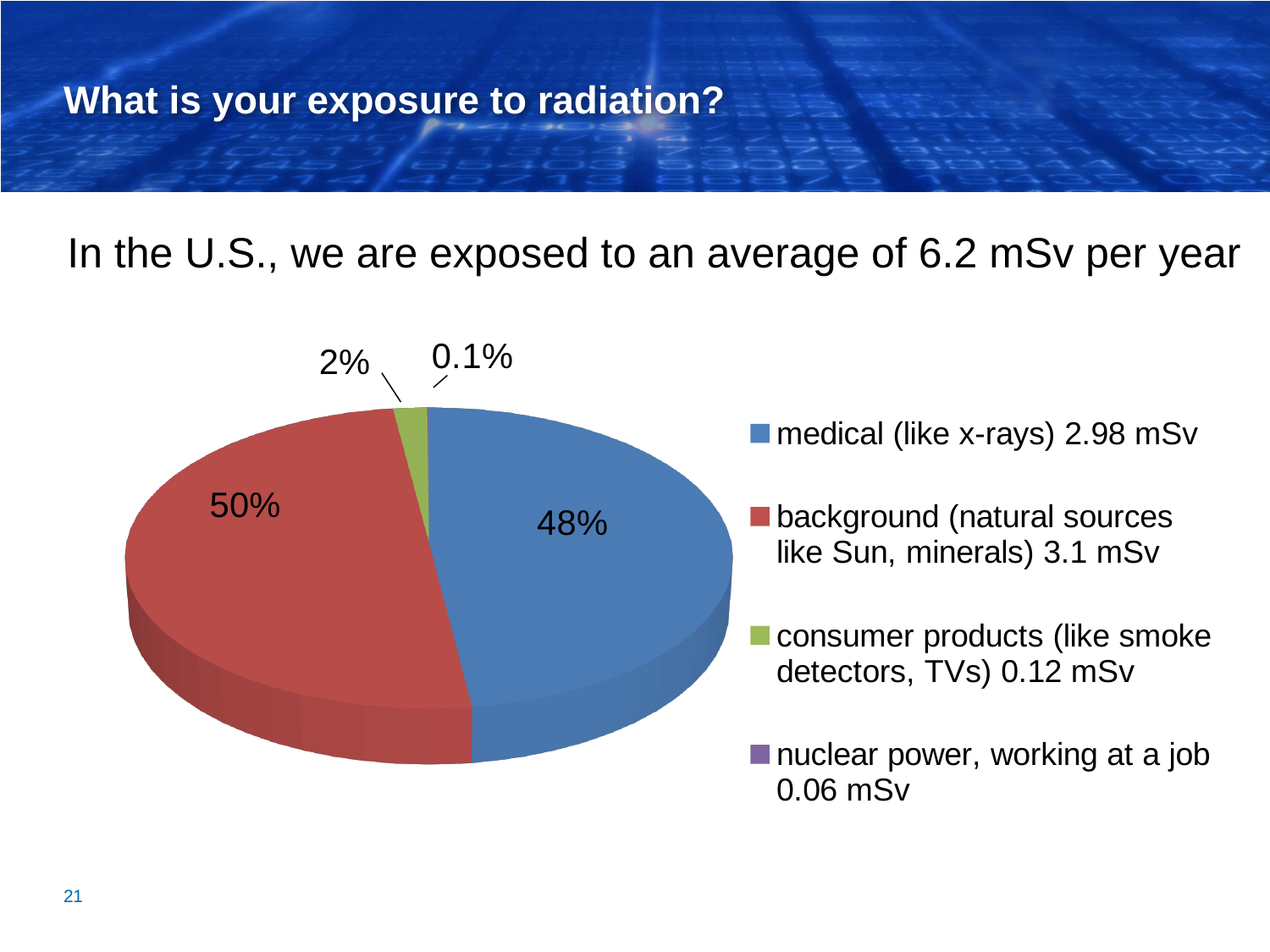
What percentage of the pie is labelled for the background (natural sources like Sun, minerals) slice? 50% Which category has the largest share of the pie? background (natural sources like Sun, minerals) What is the difference in percentage points between the background slice and the medical slice? 2 How many categories does the legend list? 4 What percentage of the pie is labelled for the nuclear power, working at a job slice? 0.1% What percentage of the pie is labelled for the consumer products (like smoke detectors, TVs) slice? 2% What colour is the slice for medical (like x-rays)? blue Which is larger, the consumer products slice or the nuclear power slice? consumer products According to the legend, how many mSv is attributed to consumer products (like smoke detectors, TVs)? 0.12 mSv What kind of chart is shown on the slide? pie chart Which category has the smallest share of the pie? nuclear power, working at a job What percentage of the pie is labelled for the medical (like x-rays) slice? 48%